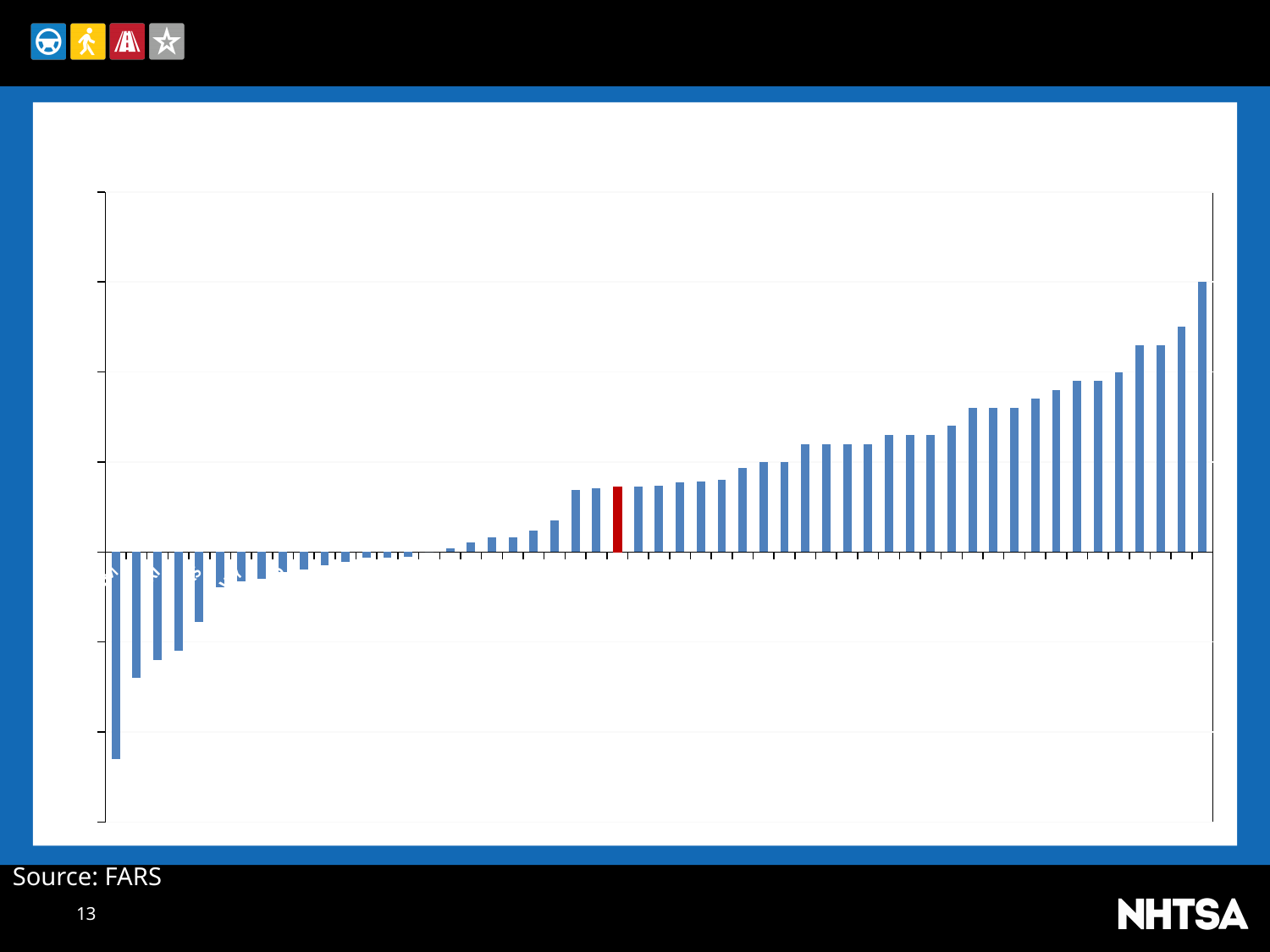
Is the value of the rightmost bar greater or less than 0 (the horizontal baseline)? greater What source is cited below the chart? FARS Do the bar values generally rise or fall from left to right along the x axis? rise Which bar is the tallest above the baseline: the leftmost bar or the rightmost bar? the rightmost bar How many bars in the chart are coloured red rather than blue? 1 What kind of chart is shown on the slide? bar chart Is the value of the leftmost bar greater or less than 0 (the horizontal baseline)? less